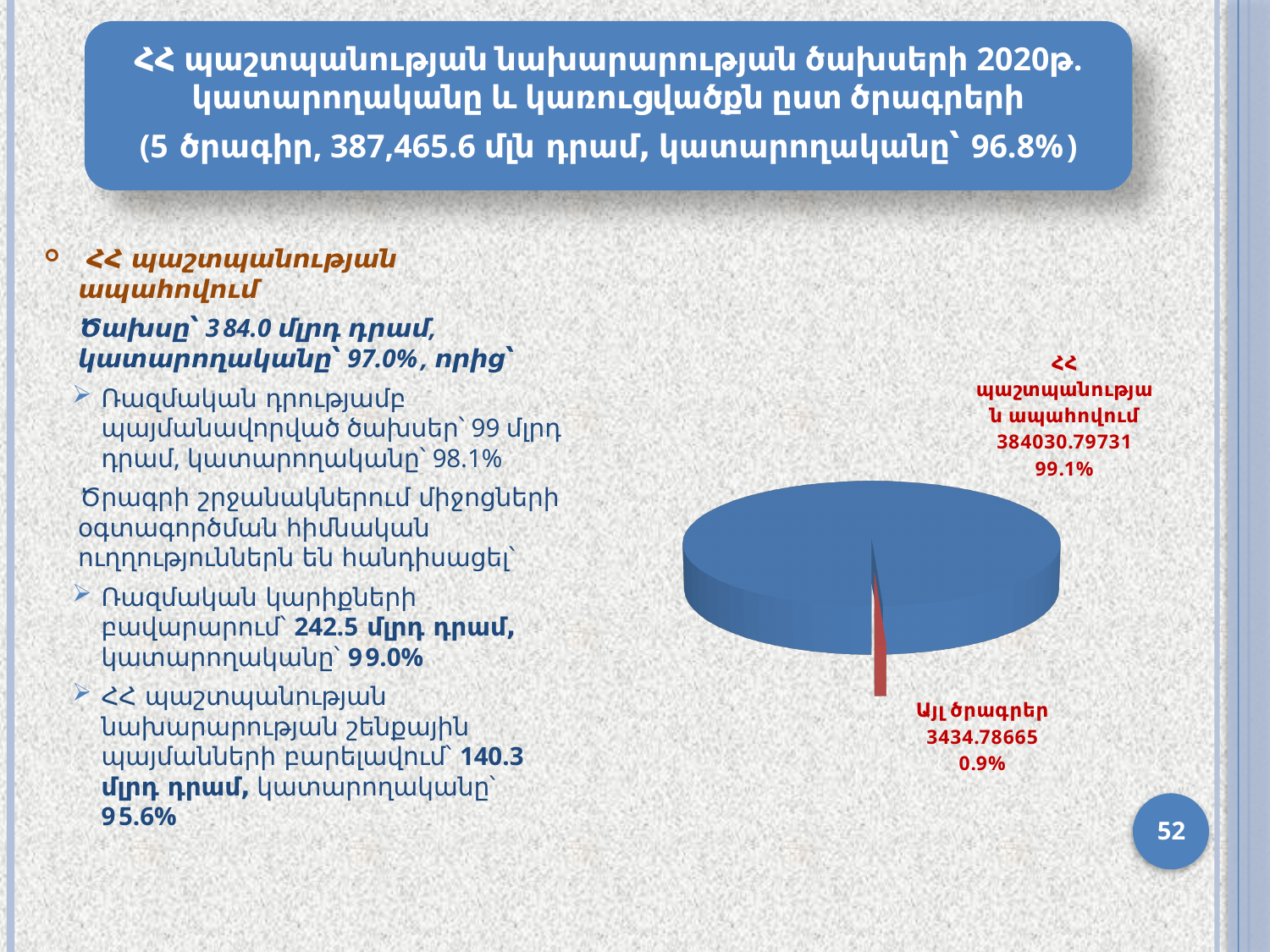
What is the difference between the percentage shares of the two slices in the pie chart? 98.2% What colour is the "ՀՀ պաշտպանության ապահովում" slice in the pie chart? blue What value is shown for the slice labelled "Այլ ծրագրեր"? 3434.78665 What kind of chart is shown on the slide? pie chart What value is shown for the slice labelled "ՀՀ պաշտպանության ապահովում"? 384030.79731 How many slices does the pie chart have? 2 What share of the pie does the "Այլ ծրագրեր" slice represent? 0.9% Which slice of the pie chart is the smallest? Այլ ծրագրեր What colour is the "Այլ ծրագրեր" slice in the pie chart? red Which is larger: the value for "ՀՀ պաշտպանության ապահովում" or the value for "Այլ ծրագրեր"? ՀՀ պաշտպանության ապահովում Which slice of the pie chart is the largest? ՀՀ պաշտպանության ապահովում What share of the pie does the "ՀՀ պաշտպանության ապահովում" slice represent? 99.1%